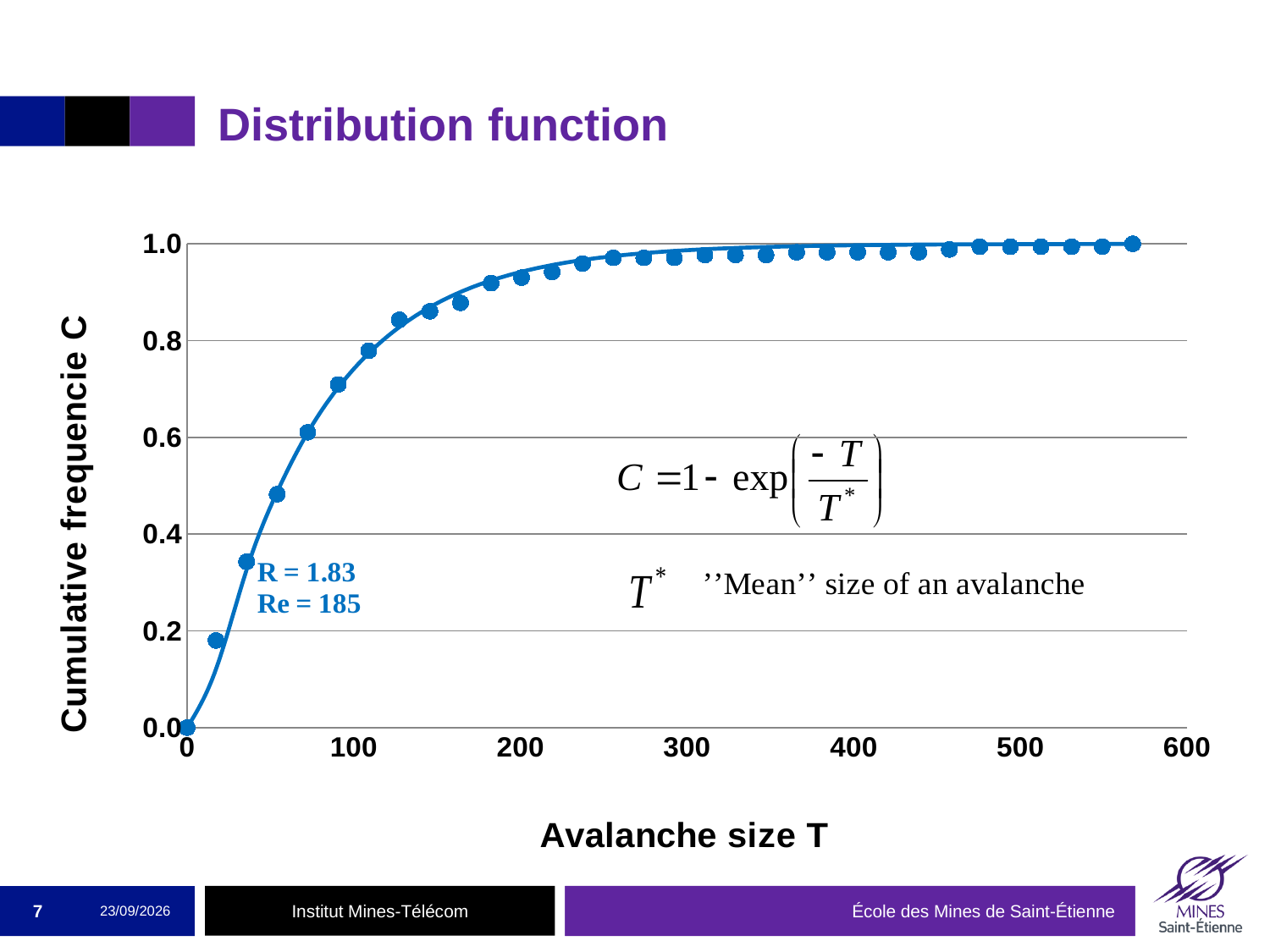
Is the cumulative frequency at T = 300 greater or less than 0.8? greater Is the cumulative frequency at T = 200 greater or less than 0.8? greater Is the cumulative frequency at T = 50 greater or less than 0.6? less Does the cumulative frequency C rise or fall as avalanche size T increases? rise At which avalanche size T is the cumulative frequency lowest? 0 What is the title of the slide's chart? Distribution function What kind of chart is shown on the slide? scatter chart with a fitted curve What is the highest value shown on the y axis? 1.0 What is the label of the x axis? Avalanche size T What is the cumulative frequency C at avalanche size T = 0? 0.0 Which is larger, the cumulative frequency at T = 100 or at T = 400? T = 400